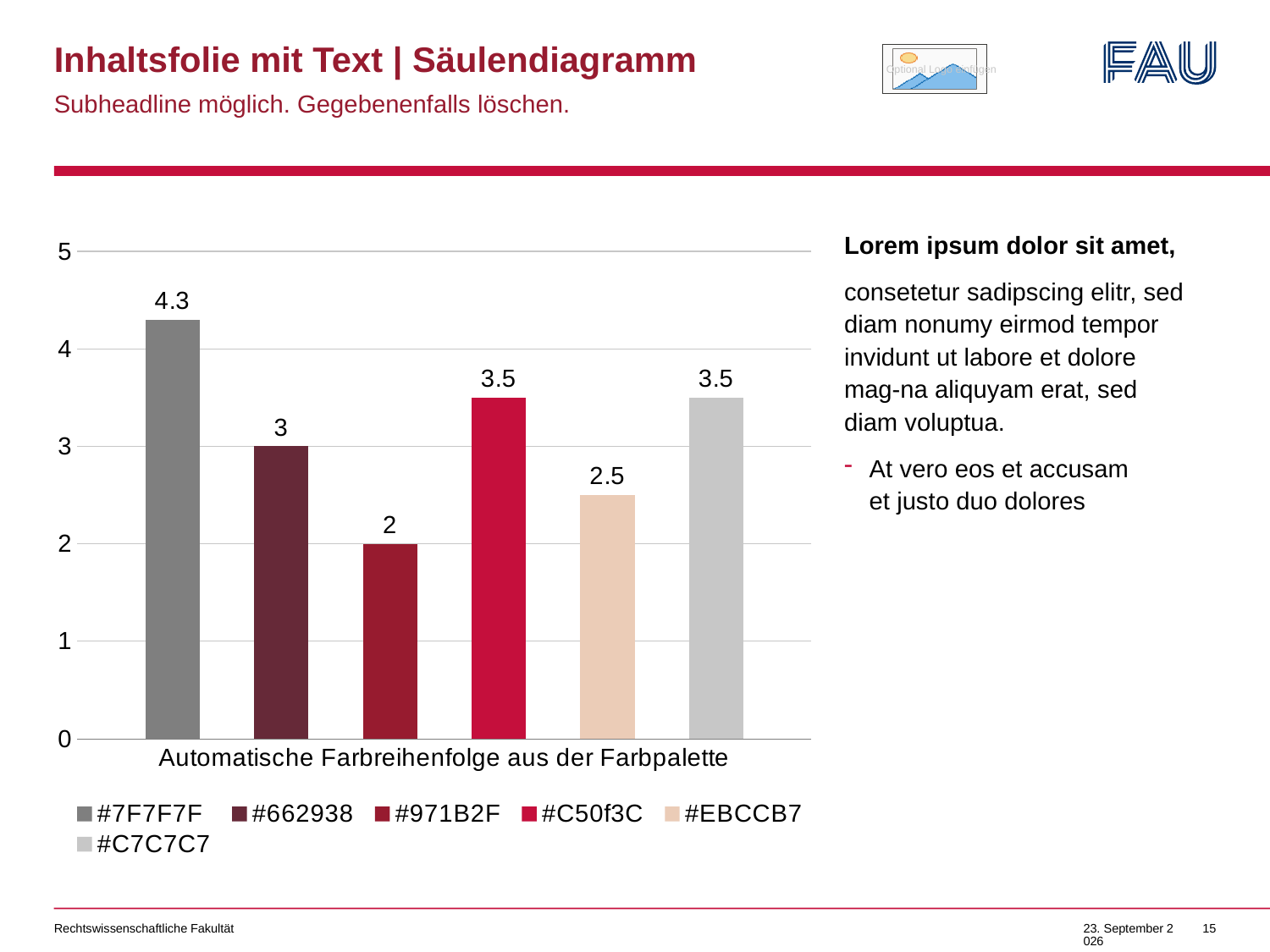
What kind of chart is shown on the slide? Bar chart Which series has the highest value? #7F7F7F Which is larger, the value of #662938 or the value of #EBCCB7? #662938 What is the difference between the values of #7F7F7F and #971B2F? 2.3 What is the value of the #7F7F7F series? 4.3 What is the value of the #662938 series? 3 How many series does the legend list? 6 What is the value of the #C50f3C series? 3.5 What is the value of the #EBCCB7 series? 2.5 What is the difference between the values of #C50f3C and #EBCCB7? 1 Which series has the lowest value? #971B2F What is the category label shown on the x axis? Automatische Farbreihenfolge aus der Farbpalette